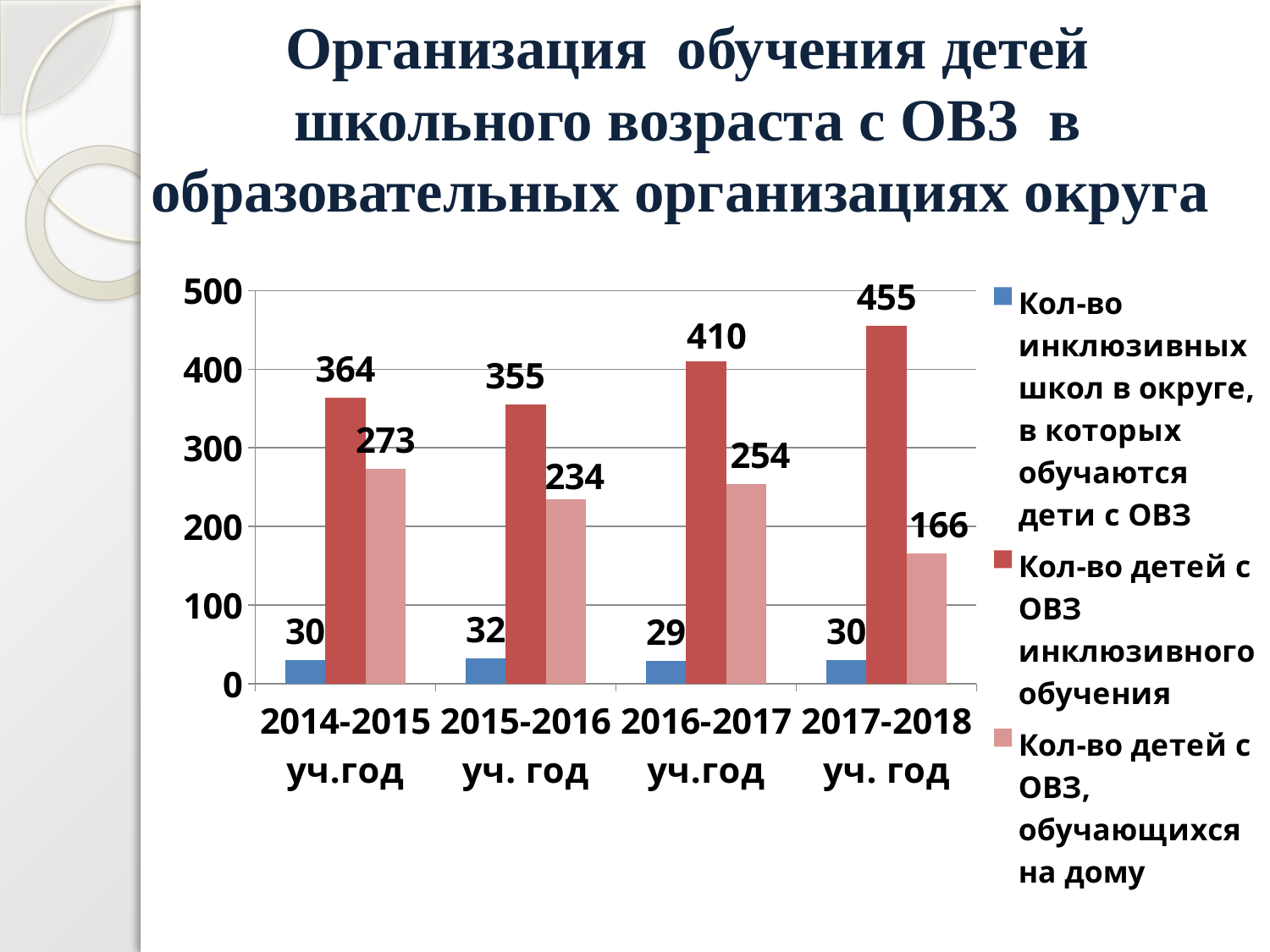
What is the difference between the number of children in inclusive education and the number studying at home in 2014-2015 уч.год? 91 In which academic year is the number of children with disabilities studying at home the lowest? 2017-2018 уч. год How many series does the legend list? 3 Which is larger in 2016-2017 уч.год: the number of children in inclusive education or the number studying at home? Inclusive education (410) What kind of chart is shown on the slide? Bar chart Which colour represents the number of inclusive schools in the district? Blue In which academic year is the number of children with disabilities in inclusive education the highest? 2017-2018 уч. год What is the number of children with disabilities studying at home (Кол-во детей с ОВЗ, обучающихся на дому) in 2015-2016 уч. год? 234 How many inclusive schools in the district (Кол-во инклюзивных школ в округе) are shown for 2016-2017 уч.год? 29 What is the number of children with disabilities in inclusive education (Кол-во детей с ОВЗ инклюзивного обучения) in 2017-2018 уч. год? 455 Does the number of children with disabilities in inclusive education rise or fall from 2015-2016 to 2017-2018? Rise How many academic years are shown on the x axis? 4